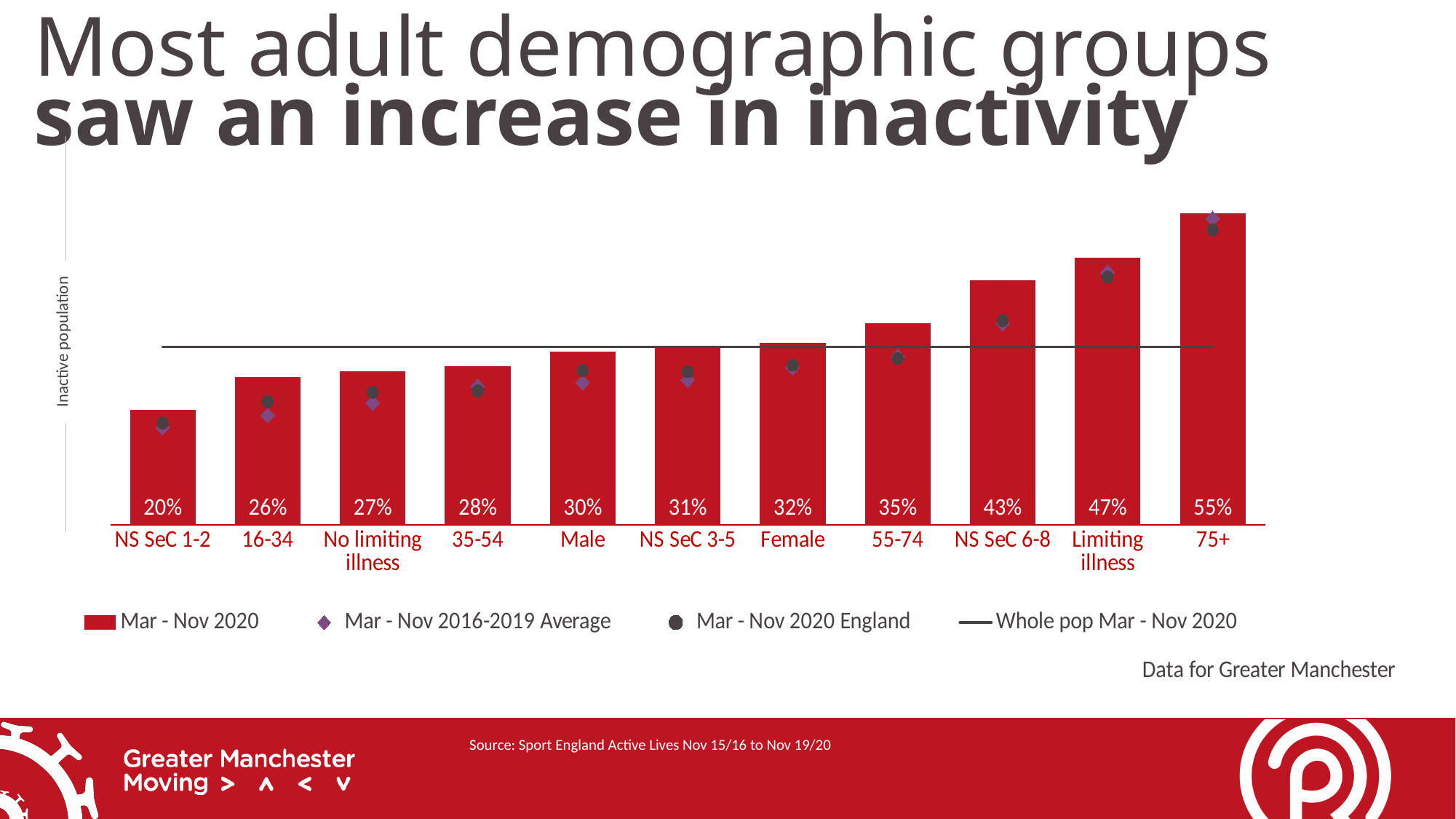
What is the Mar - Nov 2020 inactive population value for Female? 32% How many series does the legend list? 4 What is the Mar - Nov 2020 inactive population value for NS SeC 6-8? 43% Which series is represented by the horizontal line across the chart? Whole pop Mar - Nov 2020 Do the Mar - Nov 2020 bar values rise or fall from left to right along the x axis? Rise What kind of chart is shown on the slide? Bar chart Which demographic group has the lowest Mar - Nov 2020 inactivity value? NS SeC 1-2 What is the difference between the Mar - Nov 2020 values for Limiting illness and No limiting illness? 20% Which demographic group has the highest Mar - Nov 2020 inactivity value? 75+ How many demographic groups are shown on the x axis? 11 Which has the larger Mar - Nov 2020 value, Male or Female? Female What is the Mar - Nov 2020 inactive population value for the 75+ group? 55%